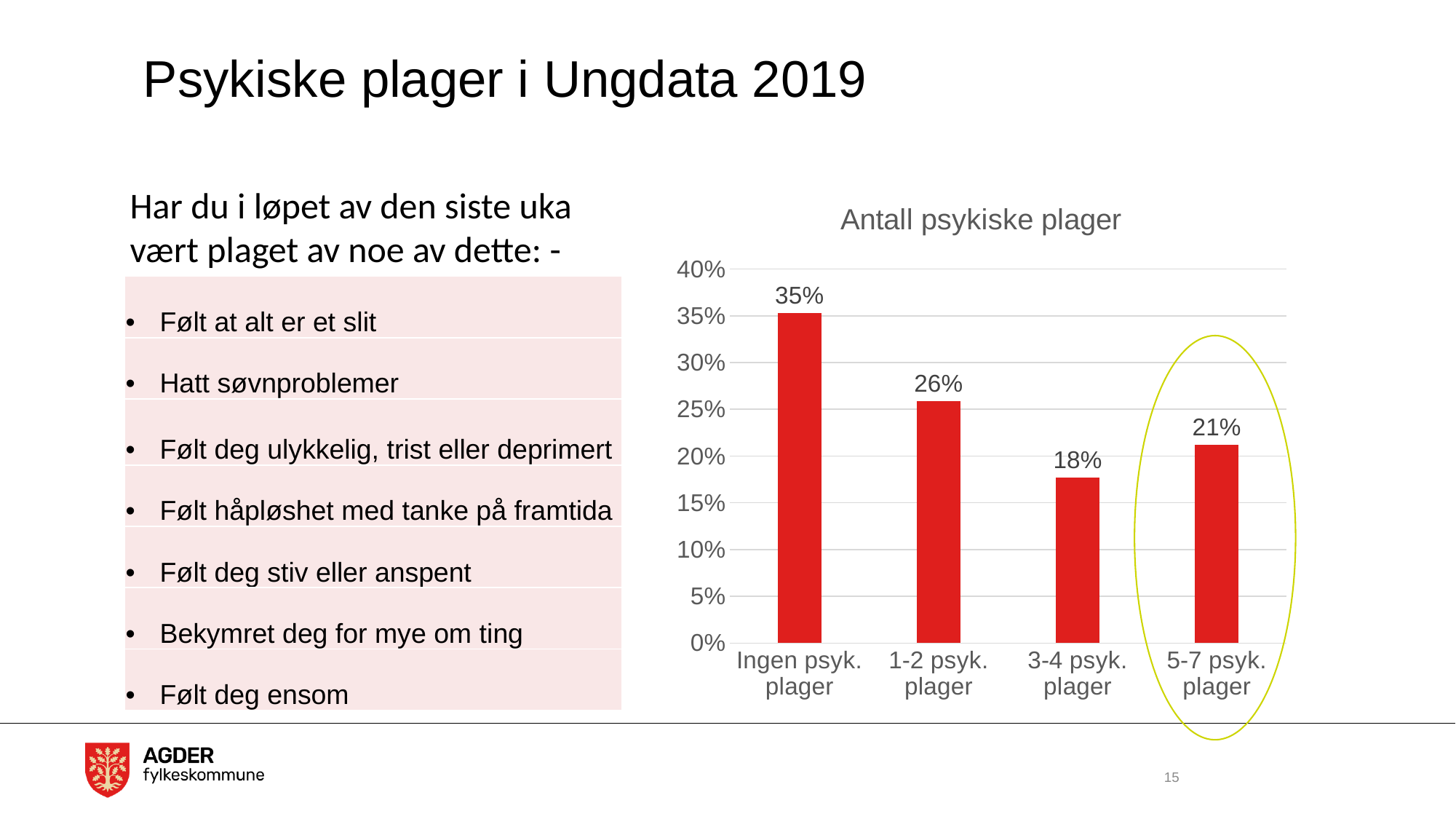
What is the value for 'Ingen psyk. plager'? 35% Which category has the lowest value? 3-4 psyk. plager Which category has the highest value? Ingen psyk. plager What kind of chart is shown on the slide? Bar chart What is the value for '3-4 psyk. plager'? 18% Which is larger, the value for '1-2 psyk. plager' or '5-7 psyk. plager'? 1-2 psyk. plager What is the difference between the values for '5-7 psyk. plager' and '3-4 psyk. plager'? 3% How many categories are shown in the chart? 4 What is the value for '1-2 psyk. plager'? 26% What is the value for '5-7 psyk. plager'? 21% What is the difference between the values for 'Ingen psyk. plager' and '1-2 psyk. plager'? 9% What is the title of the chart? Antall psykiske plager